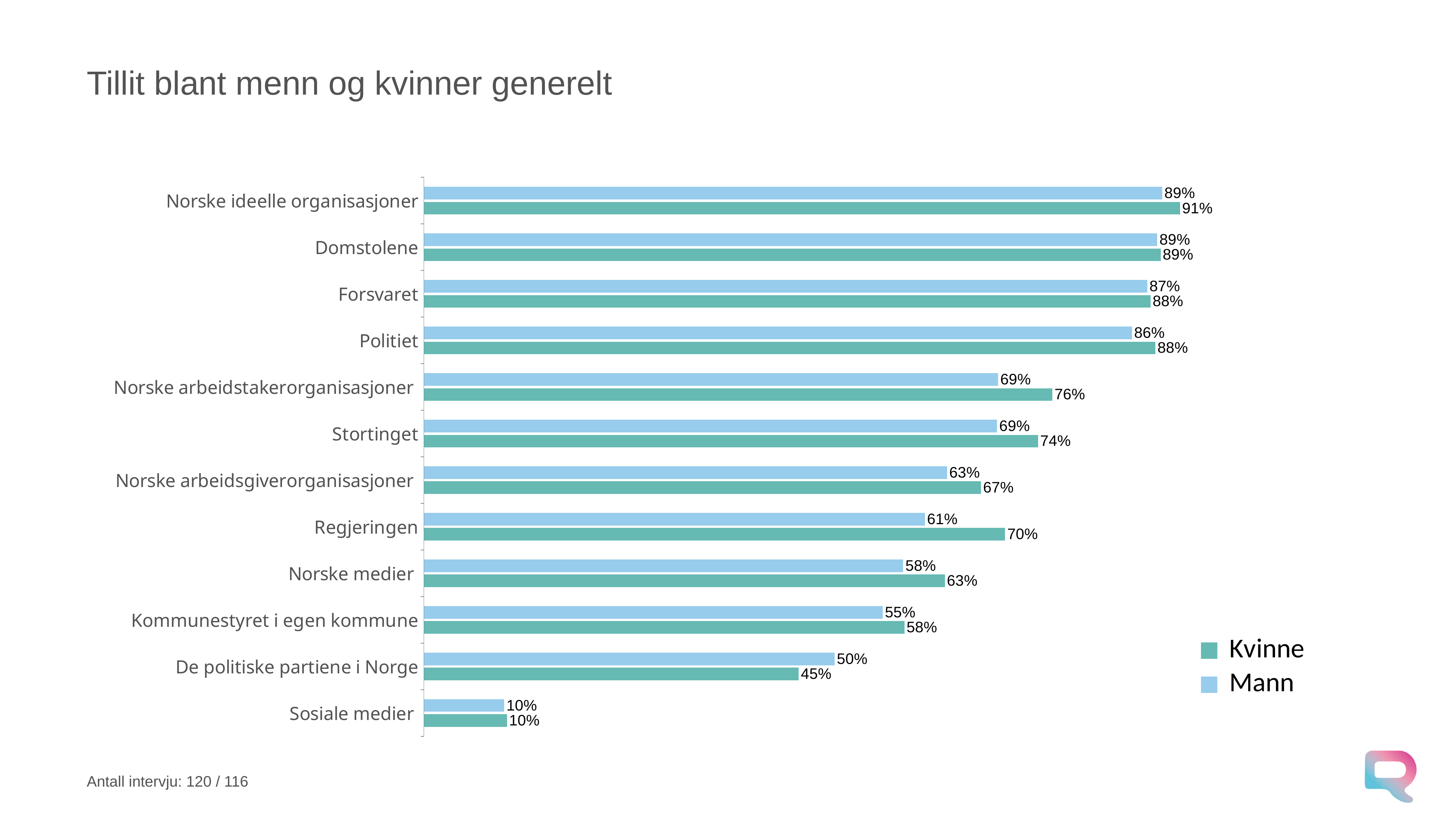
What is the difference between the Kvinne and Mann values for Norske arbeidstakerorganisasjoner? 7% How many categories are shown on the chart? 12 Which category has the highest Kvinne value? Norske ideelle organisasjoner Which category has the lowest Mann value? Sosiale medier What is the Kvinne value for Norske ideelle organisasjoner? 91% What is the difference between the Kvinne and Mann values for Regjeringen? 9% How many series does the legend list? 2 What is the Kvinne value for De politiske partiene i Norge? 45% What kind of chart is shown on the slide? Bar chart Which is larger: the Kvinne value for Stortinget or the Kvinne value for Norske medier? Stortinget For De politiske partiene i Norge, which is larger: the Kvinne value or the Mann value? Mann What is the Mann value for Regjeringen? 61%